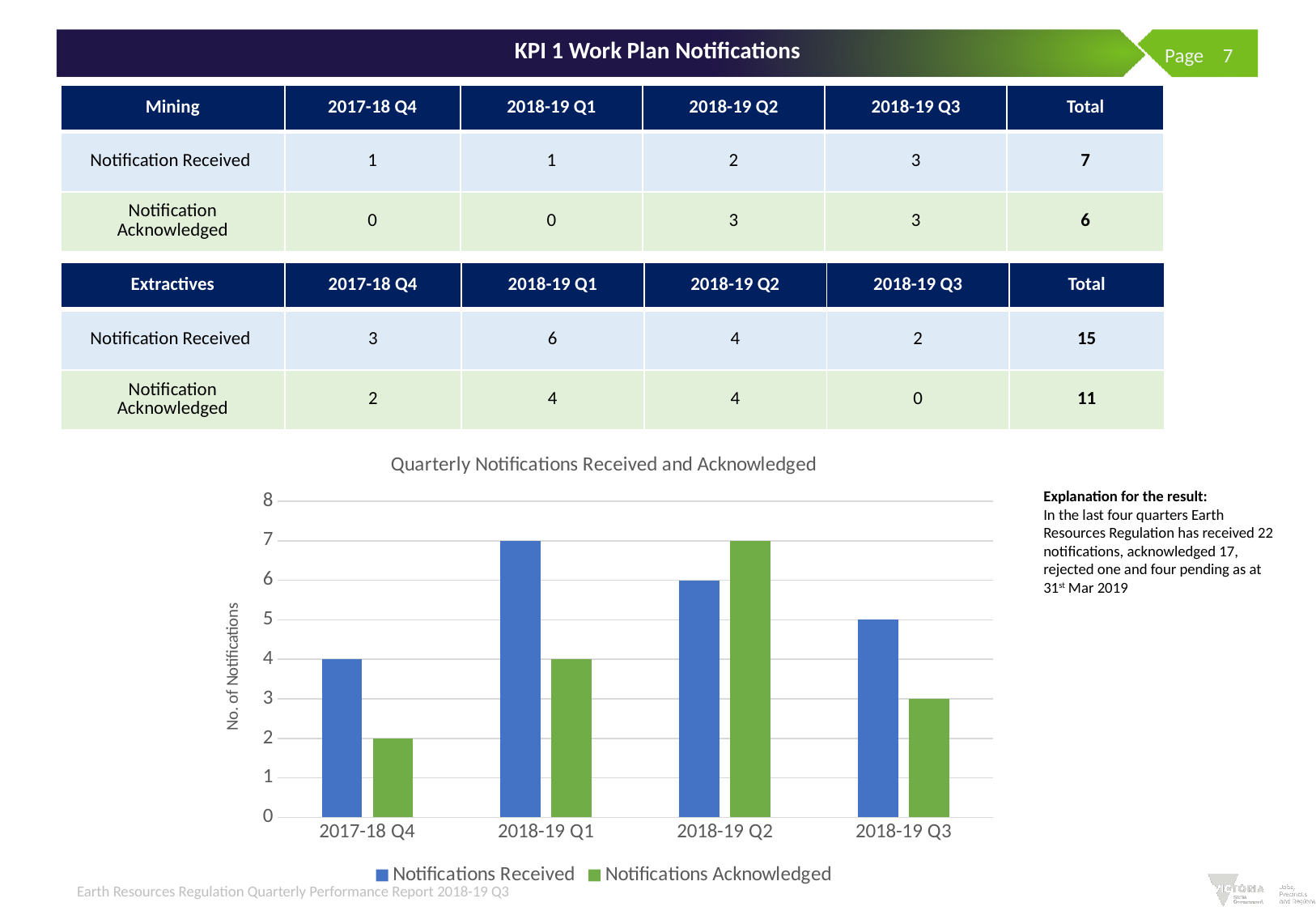
What type of chart is shown on the slide? Bar chart What is the title of the chart? Quarterly Notifications Received and Acknowledged Which quarter has the highest value for Notifications Received? 2018-19 Q1 Is the value for Notifications Received in 2017-18 Q4 greater or less than 5? less How many quarters are shown on the x axis of the chart? 4 What is the difference between Notifications Received and Notifications Acknowledged in 2018-19 Q3? 2 Which quarter has the lowest value for Notifications Acknowledged? 2017-18 Q4 What is the value of Notifications Acknowledged for 2017-18 Q4? 2 What is the value of Notifications Acknowledged for 2018-19 Q2? 7 How many series does the chart legend list? 2 In 2018-19 Q2, which is larger: Notifications Received or Notifications Acknowledged? Notifications Acknowledged What is the value of Notifications Received for 2018-19 Q1? 7